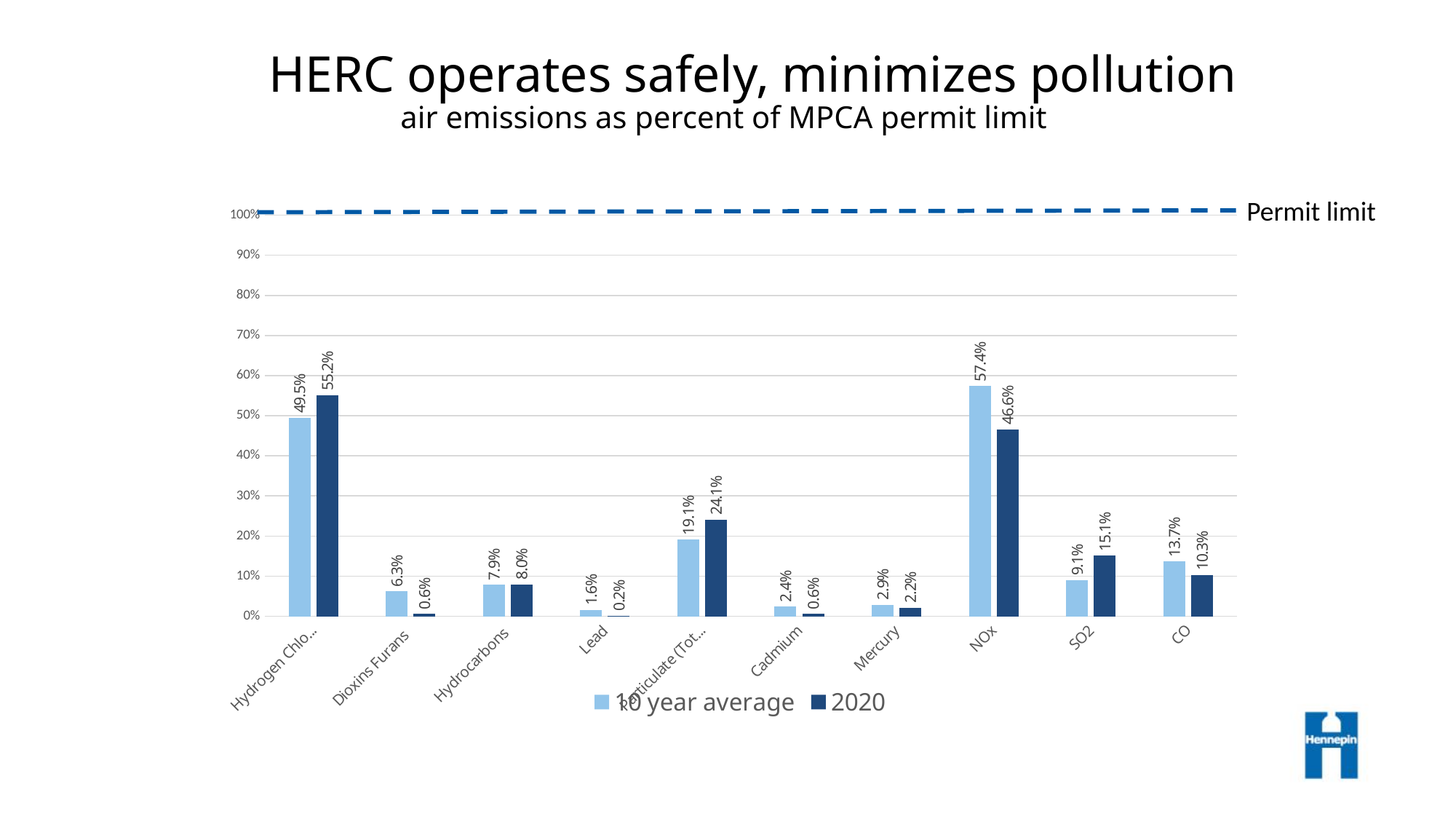
Which category has the highest 10 year average value? NOx Which category has the lowest 2020 value? Lead How many series does the legend list? 2 What is the 2020 value for Mercury? 2.2% Which is larger for SO2, the 10 year average or the 2020 value? 2020 What is the difference between the 10 year average and 2020 values for CO? 3.4% What does the dashed horizontal line at 100% represent? Permit limit Is the 10 year average value for NOx greater or less than 50%? greater What kind of chart is shown on the slide? bar chart What is the 10 year average value for SO2? 9.1% What is the 2020 value for NOx? 46.6% How many categories are shown on the x axis? 10